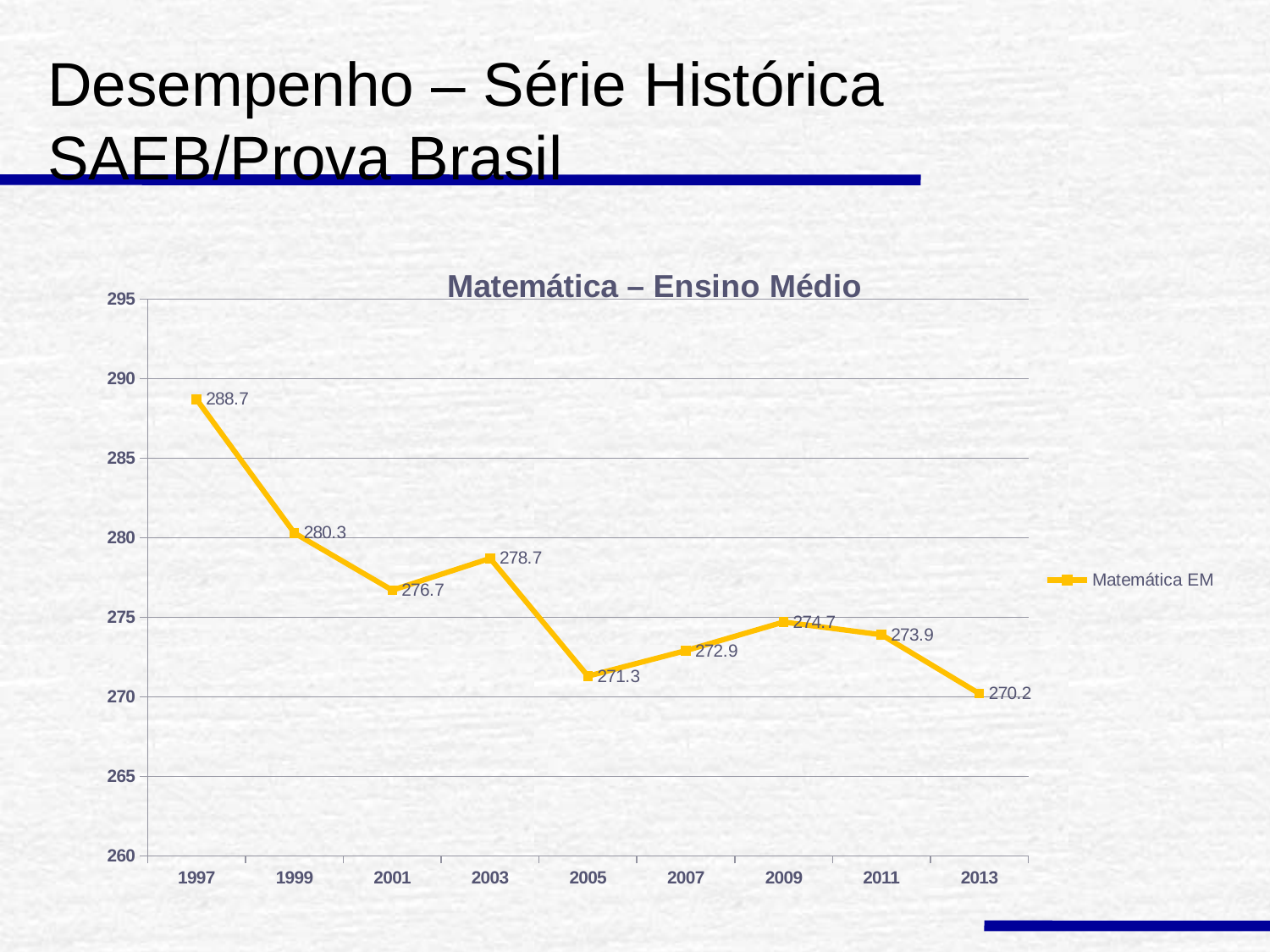
How many years are plotted on the x axis? 9 What is the title of the chart? Matemática – Ensino Médio What is the value for 2005? 271.3 What is the value for 2013? 270.2 Is the value for 2009 greater or less than 275? less What is the value for 1997? 288.7 How many series does the legend list? 1 Which year has the highest value? 1997 What is the difference between the values for 1997 and 2013? 18.5 Which year has the lowest value? 2013 What kind of chart is shown? line chart Which is larger, the value for 2003 or the value for 2001? 2003